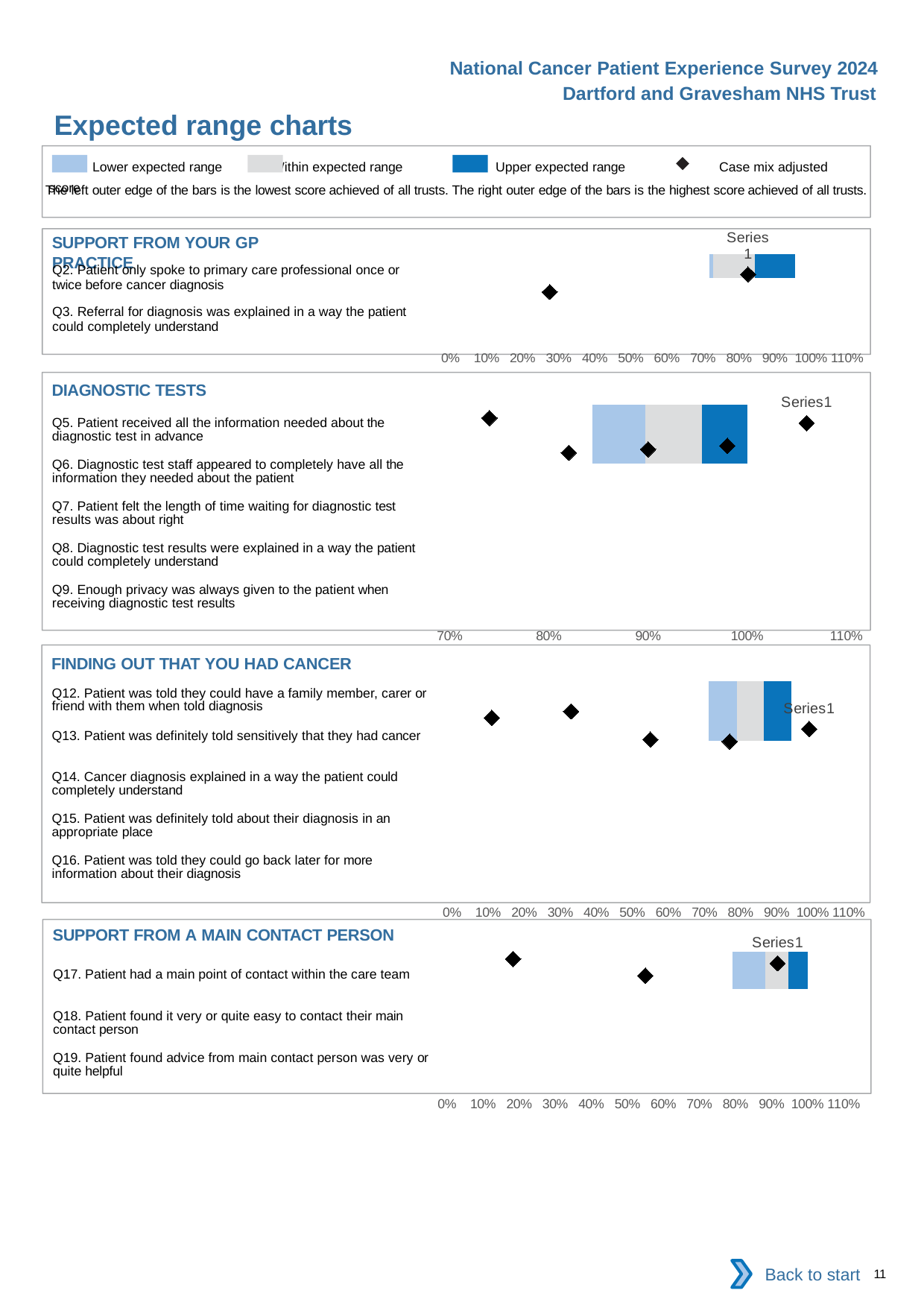
What is the lowest value shown on the x axis of the 'DIAGNOSTIC TESTS' chart? 70% In the 'SUPPORT FROM A MAIN CONTACT PERSON' chart, how many questions (categories) are listed? 3 What is the highest value shown on the x axis of the 'SUPPORT FROM A MAIN CONTACT PERSON' chart? 110% How many entries does the legend at the top of the slide list? 4 What is the title of the first chart on the slide? SUPPORT FROM YOUR GP PRACTICE In the 'FINDING OUT THAT YOU HAD CANCER' chart, how many questions (categories) are listed? 5 In the 'DIAGNOSTIC TESTS' chart, how many questions (categories) are listed? 5 What kind of chart is the 'DIAGNOSTIC TESTS' chart? bar chart